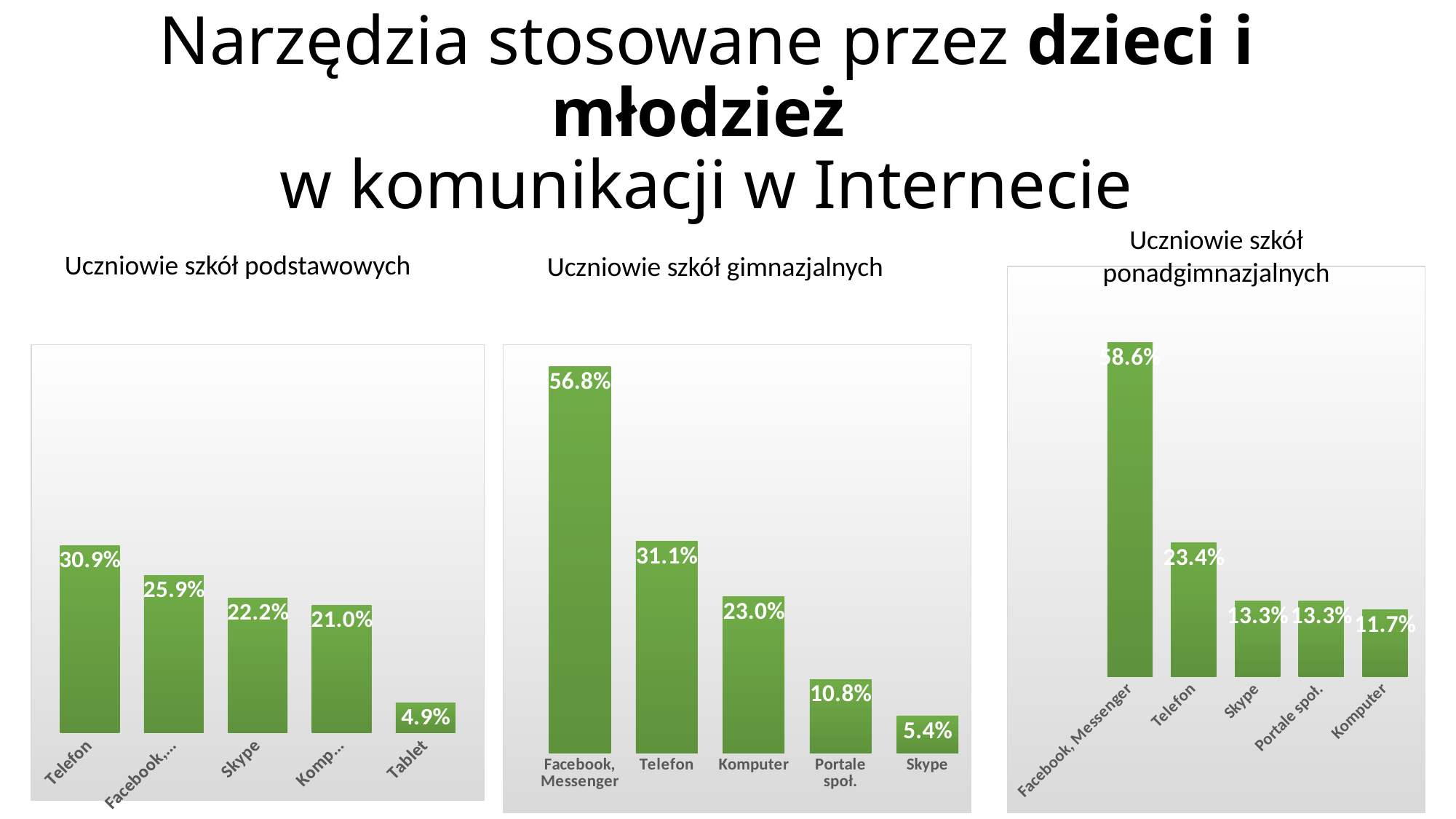
In the chart titled 'Uczniowie szkół podstawowych', which category has the lowest value? Tablet In the chart titled 'Uczniowie szkół podstawowych', what is the difference between Telefon and Skype? 8.7% In the chart titled 'Uczniowie szkół ponadgimnazjalnych', what is the difference between Skype and Komputer? 1.6% In the chart titled 'Uczniowie szkół gimnazjalnych', what is the value for Facebook, Messenger? 56.8% In the chart titled 'Uczniowie szkół ponadgimnazjalnych', which is larger, Telefon or Komputer? Telefon In the chart titled 'Uczniowie szkół gimnazjalnych', which category has the highest value? Facebook, Messenger In the chart titled 'Uczniowie szkół gimnazjalnych', what is the value for Portale społ.? 10.8% In the chart titled 'Uczniowie szkół podstawowych', what is the value for Telefon? 30.9% In the chart titled 'Uczniowie szkół gimnazjalnych', how many categories are shown? 5 In the chart titled 'Uczniowie szkół podstawowych', what is the value for Tablet? 4.9% What kind of chart is the chart titled 'Uczniowie szkół gimnazjalnych'? Bar chart In the chart titled 'Uczniowie szkół ponadgimnazjalnych', what is the value for Telefon? 23.4%